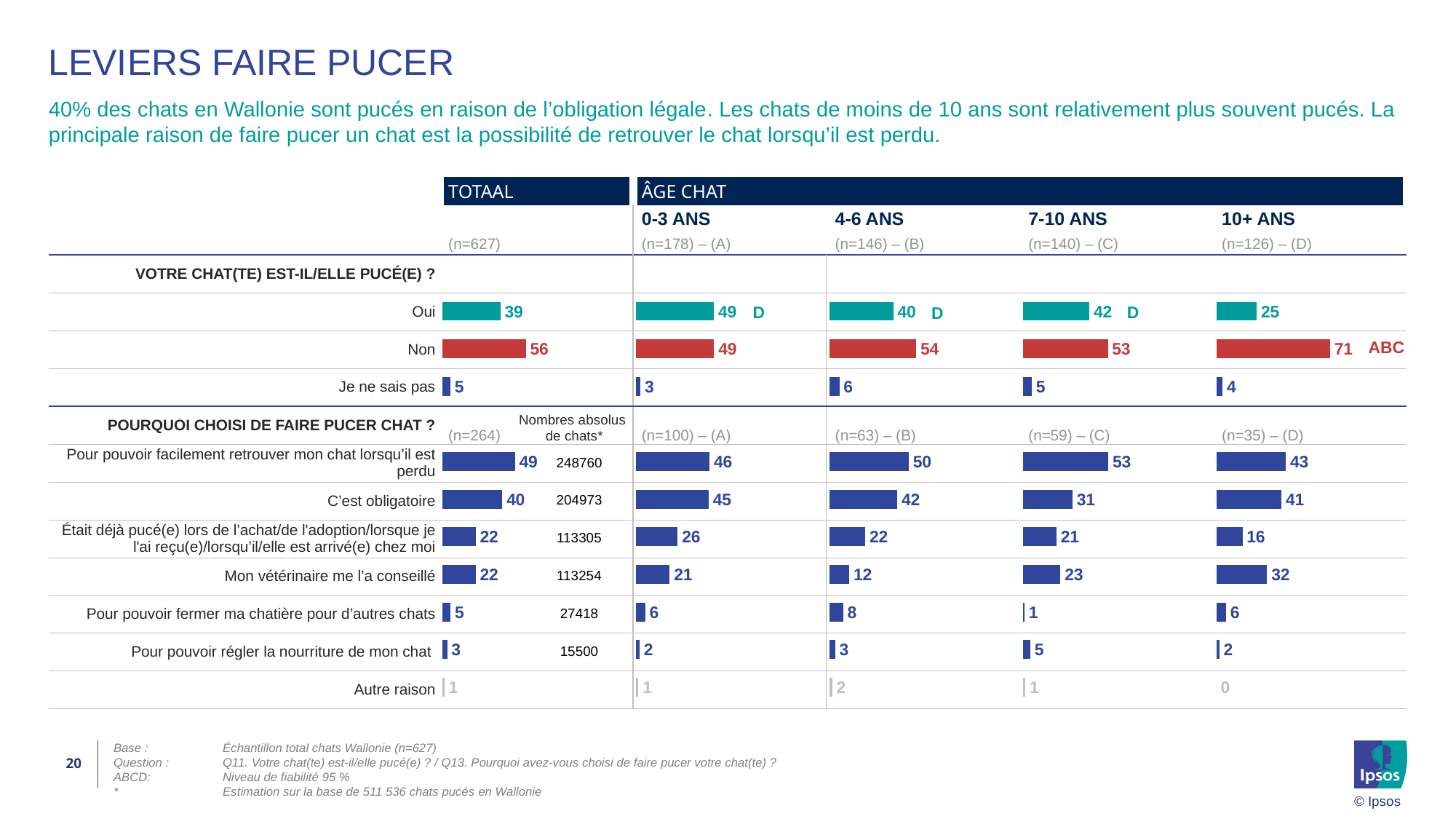
For "Mon vétérinaire me l'a conseillé", which is larger: the value for 4-6 ANS or the value for 10+ ANS? 10+ ANS Which age group has the highest value for "Oui" (cat is chipped)? 0-3 ANS Which age group has the lowest value for "Oui" (cat is chipped)? 10+ ANS What is the difference between the "Non" value for 10+ ANS and the "Non" value for 0-3 ANS? 22 What type of chart is used to display the values on this slide? Bar chart In the TOTAAL column, what is the value for "C'est obligatoire"? 40 In the 7-10 ANS column, what is the value for "Pour pouvoir fermer ma chatière pour d'autres chats"? 1 Which age group has the lowest value for "C'est obligatoire"? 7-10 ANS In the 10+ ANS column, what is the value for "Non"? 71 In the TOTAAL column, what is the value for "Non" to the question "Votre chat(te) est-il/elle pucé(e) ?"? 56 What is the absolute number of cats (Nombres absolus de chats) for "Pour pouvoir facilement retrouver mon chat lorsqu'il est perdu"? 248760 How many reasons are listed under "Pourquoi choisi de faire pucer chat ?"? 7